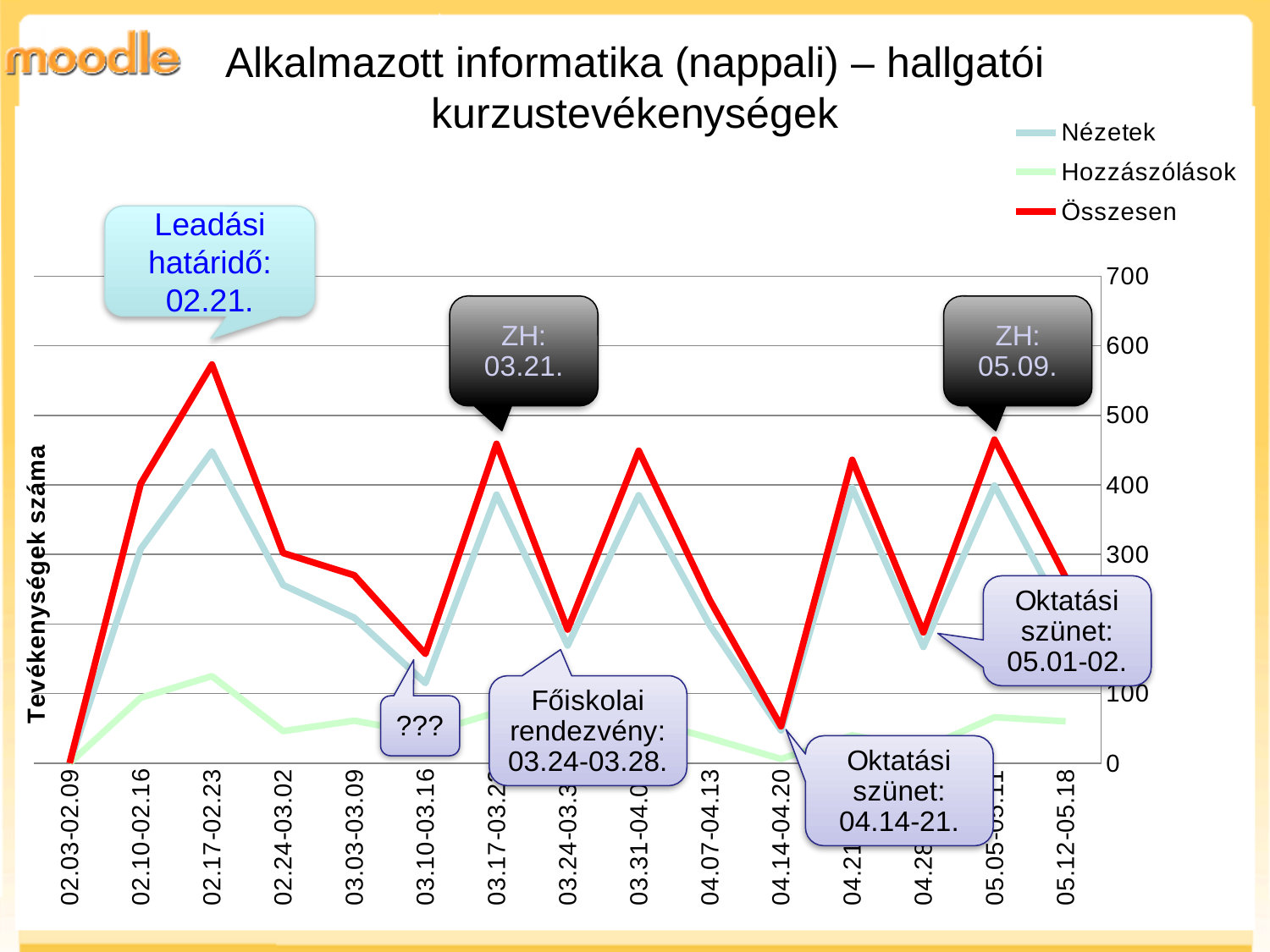
Is the value of Nézetek for 02.17-02.23 greater or less than 400? greater Is the value of Összesen for 03.10-03.16 greater or less than 200? less Which is larger for the Összesen series: the value for 02.17-02.23 or the value for 03.17-03.23? 02.17-02.23 Does the Összesen series rise or fall from 02.17-02.23 to 03.10-03.16? fall What kind of chart is shown on the slide? line chart In which week does the Összesen series reach its highest value? 02.17-02.23 Is the value of Hozzászólások for 02.17-02.23 greater or less than 200? less How many weekly categories are plotted along the x axis? 15 How many series does the legend list? 3 What is the label of the vertical axis? Tevékenységek száma In which week is the Összesen series at its lowest value? 02.03-02.09